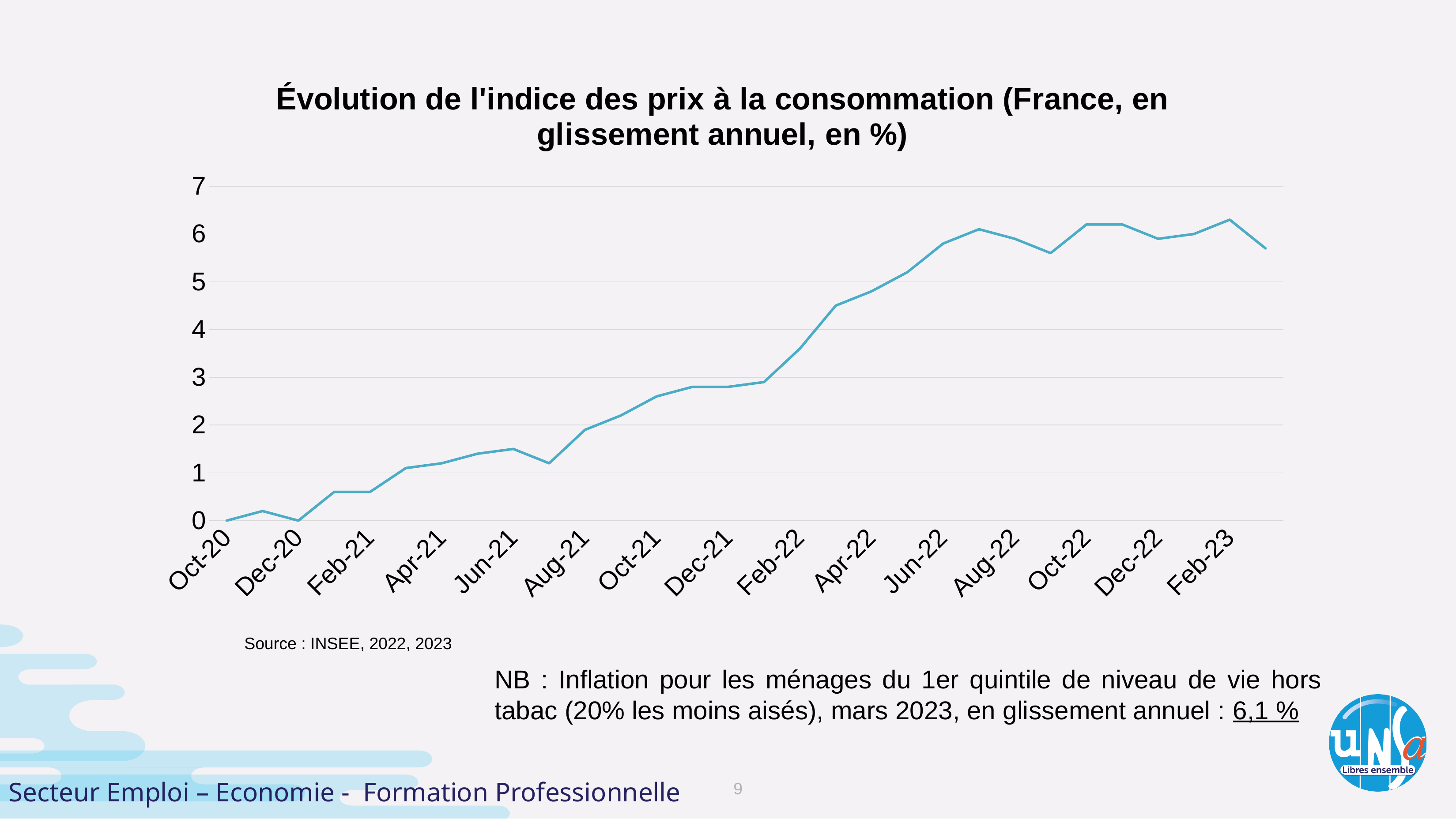
Which is larger, the value for Jun-21 or the value for Aug-21? Aug-21 Is the value for Oct-21 greater or less than 2? greater What is the title of the chart? Évolution de l'indice des prix à la consommation (France, en glissement annuel, en %) Overall, do the values rise or fall from Oct-20 to Feb-23? rise What kind of chart is shown on the slide? line chart Is the value for Feb-21 greater or less than 1? less Is the value for Apr-22 greater or less than 4? greater What is the value for Dec-20? 0 What is the value for Oct-20? 0 What source is cited below the chart? INSEE, 2022, 2023